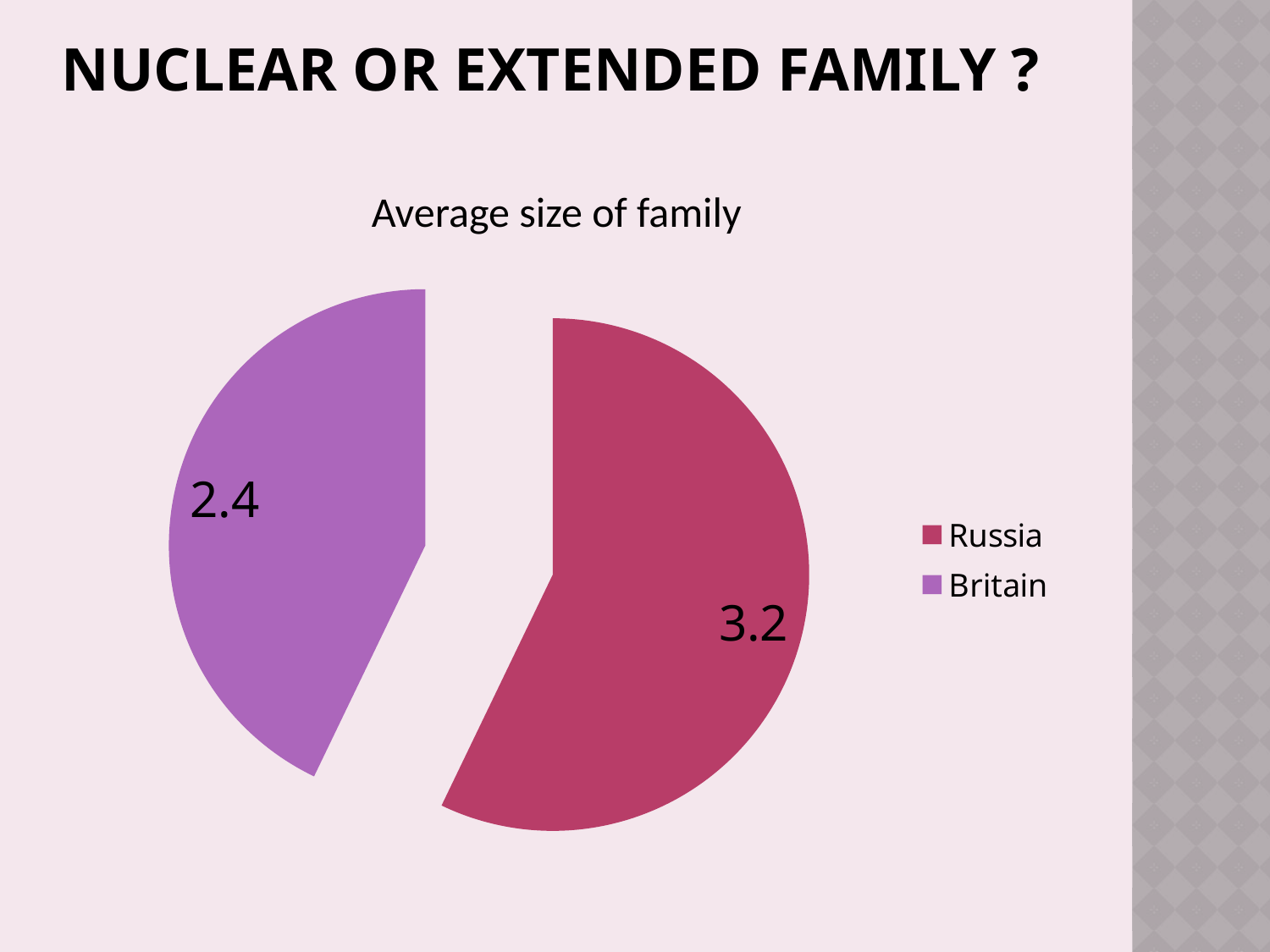
What kind of chart is shown on the slide? pie chart Which country has the smaller average family size? Britain What is the average family size shown for Britain? 2.4 Which colour represents Britain in the chart? purple What is the total of the two values shown in the pie chart? 5.6 What is the title of the chart? Average size of family How many entries does the legend list? 2 Is the value for Russia larger or smaller than the value for Britain? larger What is the difference between the average family size in Russia and in Britain? 0.8 What is the average family size shown for Russia? 3.2 Which country has the larger average family size? Russia How many slices does the pie chart have? 2